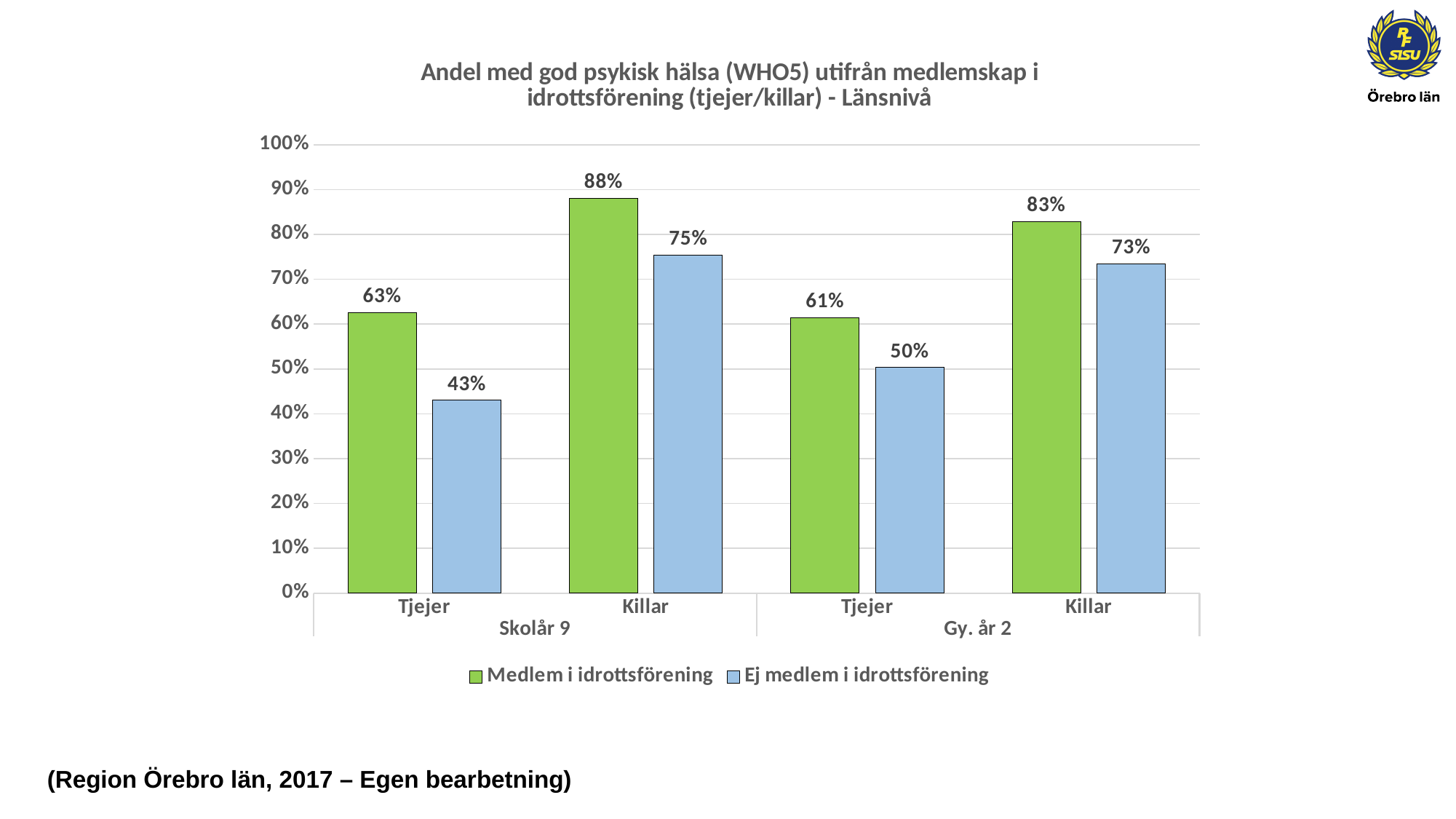
Which is larger: the Ej medlem i idrottsförening value for Killar in Skolår 9 or for Killar in Gy. år 2? Killar in Skolår 9 What is the value for Tjejer in Gy. år 2 for the series Ej medlem i idrottsförening? 50% What is the value for Killar in Gy. år 2 for the series Ej medlem i idrottsförening? 73% Is the value for Tjejer in Gy. år 2 for Medlem i idrottsförening greater or less than 50%? greater How many series does the legend list? 2 What kind of chart is shown on the slide? Bar chart Which group has the highest value for Medlem i idrottsförening? Killar, Skolår 9 What is the difference between Medlem i idrottsförening and Ej medlem i idrottsförening for Tjejer in Skolår 9? 20% Which group has the lowest value for Ej medlem i idrottsförening? Tjejer, Skolår 9 What is the value for Tjejer in Skolår 9 for the series Medlem i idrottsförening? 63% What is the difference between Medlem i idrottsförening and Ej medlem i idrottsförening for Killar in Gy. år 2? 10% What colour are the bars for Ej medlem i idrottsförening? Blue